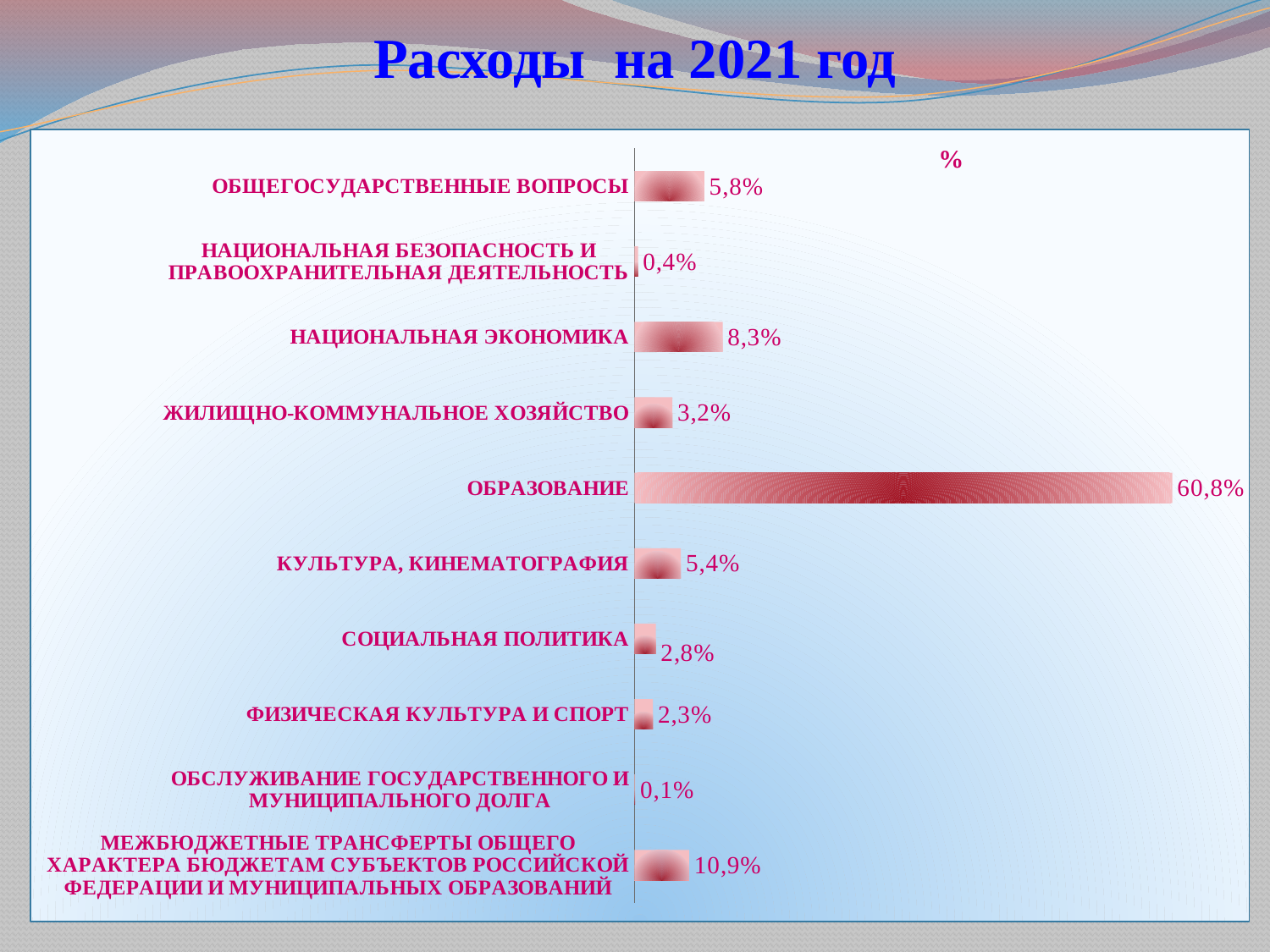
Which category has the lowest value? ОБСЛУЖИВАНИЕ ГОСУДАРСТВЕННОГО И МУНИЦИПАЛЬНОГО ДОЛГА What is the difference between the values for ОБЩЕГОСУДАРСТВЕННЫЕ ВОПРОСЫ and КУЛЬТУРА, КИНЕМАТОГРАФИЯ? 0,4% What is the value for НАЦИОНАЛЬНАЯ ЭКОНОМИКА? 8,3% What is the value for ОБСЛУЖИВАНИЕ ГОСУДАРСТВЕННОГО И МУНИЦИПАЛЬНОГО ДОЛГА? 0,1% What is the value for ЖИЛИЩНО-КОММУНАЛЬНОЕ ХОЗЯЙСТВО? 3,2% What is the value for ОБРАЗОВАНИЕ? 60,8% What is the title of the slide? Расходы на 2021 год Which category has the highest value? ОБРАЗОВАНИЕ Which is larger, the value for СОЦИАЛЬНАЯ ПОЛИТИКА or the value for ФИЗИЧЕСКАЯ КУЛЬТУРА И СПОРТ? СОЦИАЛЬНАЯ ПОЛИТИКА What kind of chart is shown on the slide? bar chart What is the difference between the values for МЕЖБЮДЖЕТНЫЕ ТРАНСФЕРТЫ ОБЩЕГО ХАРАКТЕРА and НАЦИОНАЛЬНАЯ ЭКОНОМИКА? 2,6% How many categories are shown in the chart? 10